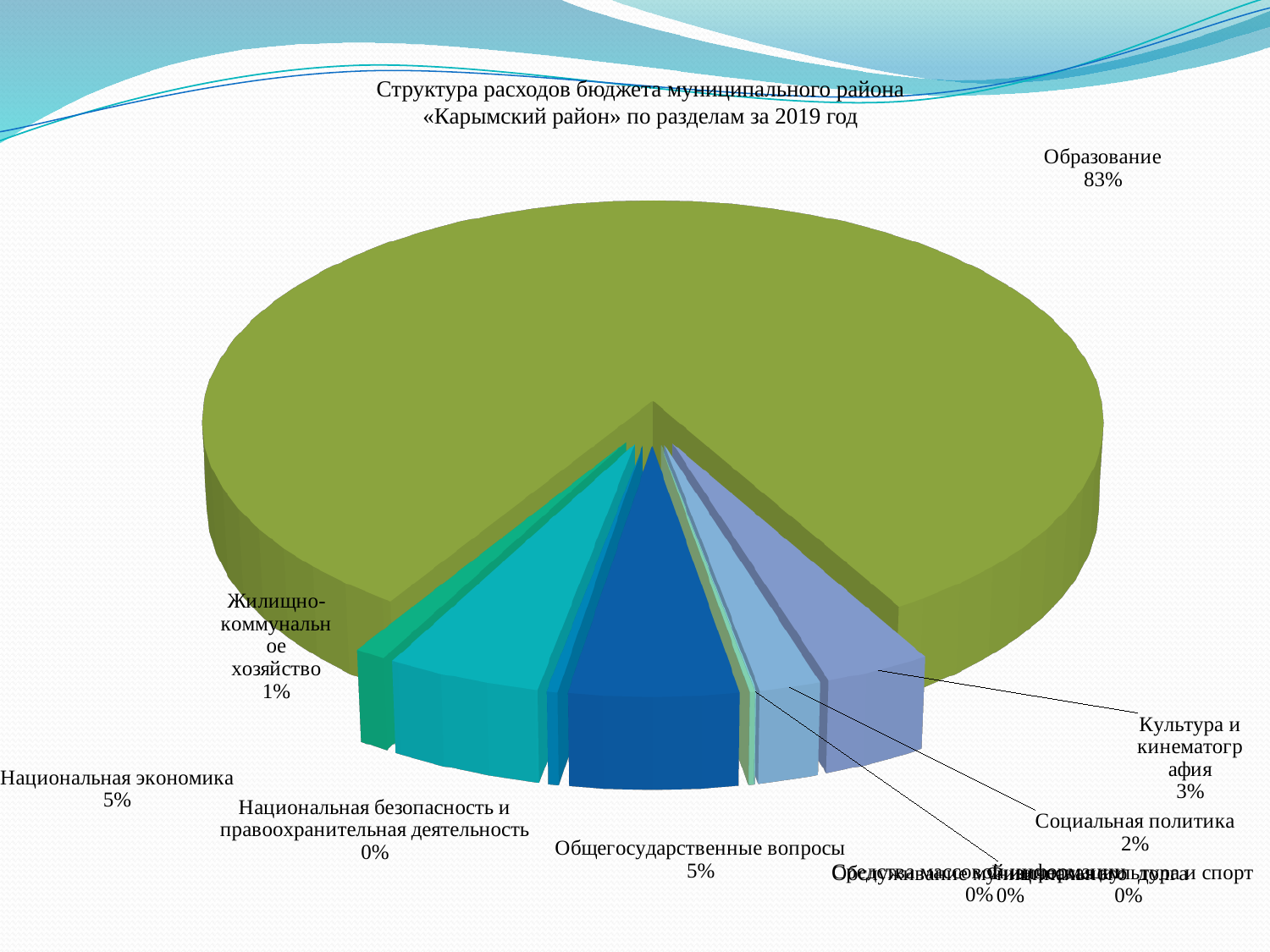
What is the value shown for Национальная экономика? 5% What is the value shown for Жилищно-коммунальное хозяйство? 1% What is the value shown for Национальная безопасность и правоохранительная деятельность? 0% Which category has the largest share of the pie? Образование What is the value shown for Социальная политика? 2% By how many percentage points does Образование exceed Национальная экономика? 78 percentage points What is the value shown for Общегосударственные вопросы? 5% What is the value shown for Культура и кинематография? 3% Which is larger, the share for Культура и кинематография or the share for Социальная политика? Культура и кинематография What kind of chart is shown on the slide? Pie chart What year does the chart title say the budget expenditure structure refers to? 2019 What share of the pie does Образование account for? 83%